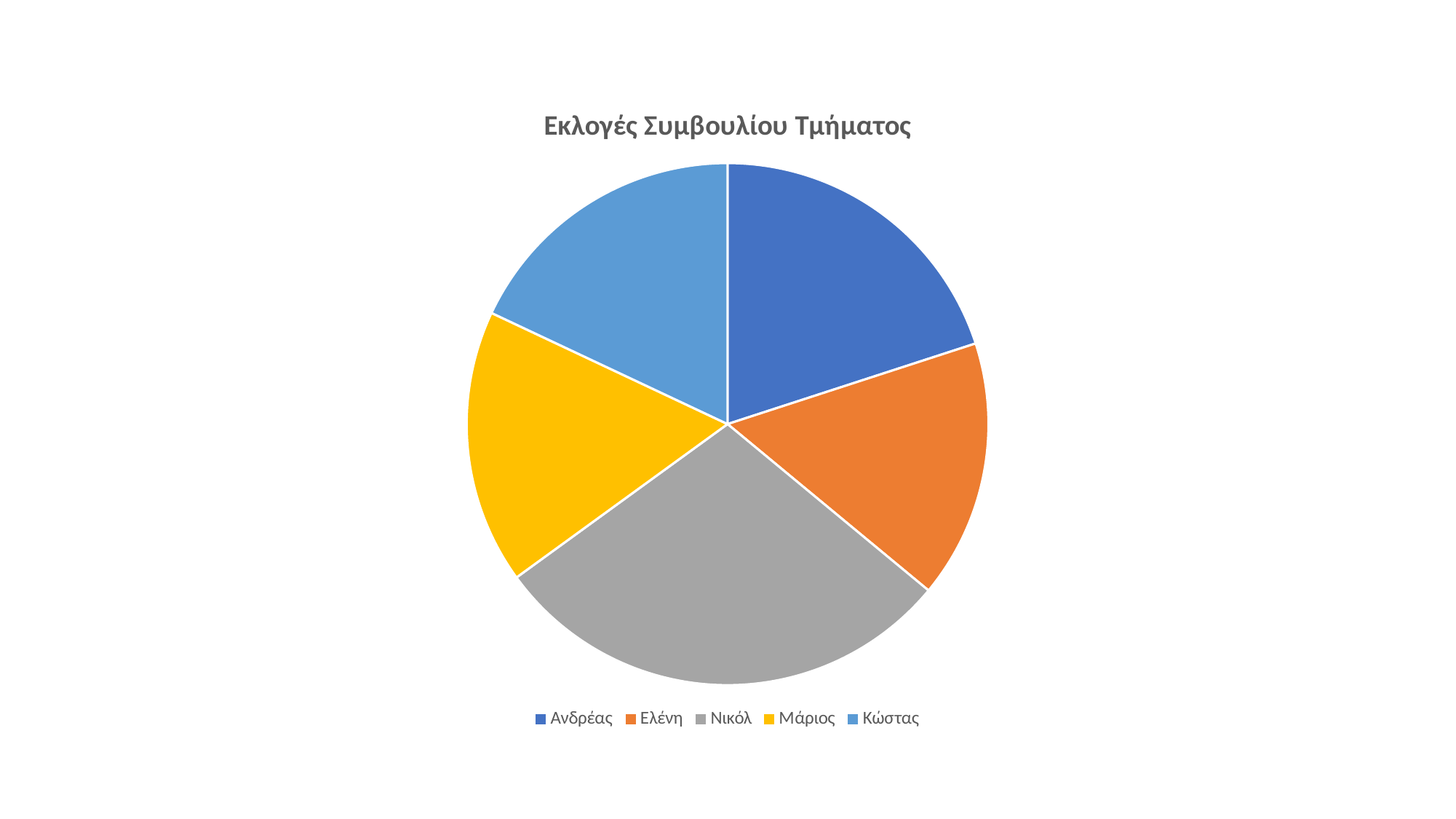
Which slice is larger, Νικόλ or Ανδρέας? Νικόλ Which category is shown in yellow? Μάριος What colour is the slice for Νικόλ? grey How many slices does the pie chart have? 5 How many entries does the legend list? 5 What kind of chart is shown on the slide? pie chart What is the title of the chart? Εκλογές Συμβουλίου Τμήματος Which slice is larger, Νικόλ or Μάριος? Νικόλ Which category has the largest slice of the pie? Νικόλ Which slice is larger, Νικόλ or Ελένη? Νικόλ